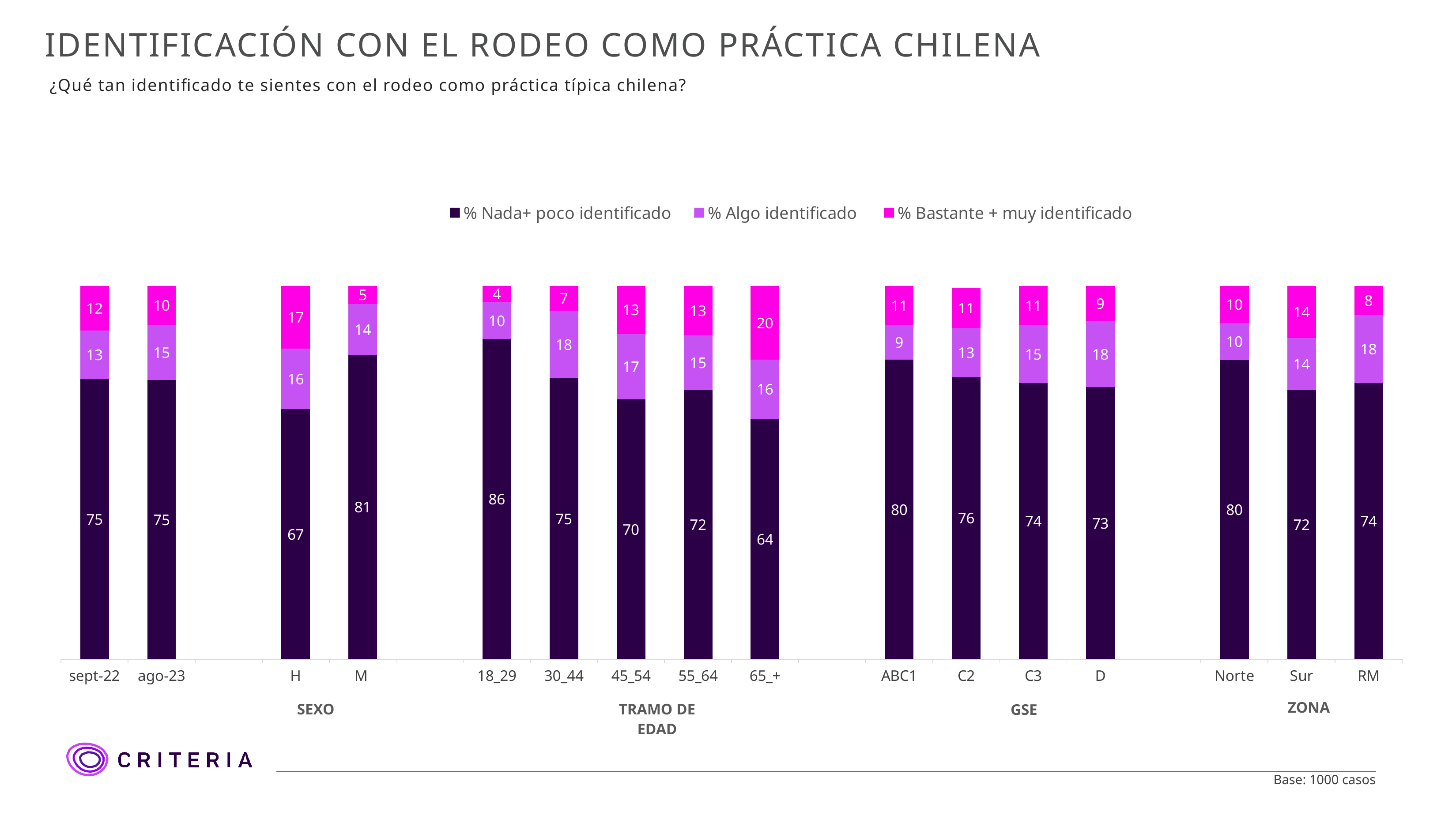
Which has a larger '% Bastante + muy identificado' value, Sur or Norte? Sur Which category has the highest value for '% Nada+ poco identificado'? 18_29 What is the value of '% Algo identificado' for RM? 18 What is the value of '% Nada+ poco identificado' for 18_29? 86 Which group label appears under the categories ABC1, C2, C3 and D? GSE What is the total of the stacked bar for ABC1? 100 What is the difference between the '% Nada+ poco identificado' values for M and H? 14 Which category has the lowest value for '% Bastante + muy identificado'? 18_29 How many series does the legend list? 3 How many categories are plotted along the x axis? 16 What kind of chart is shown on the slide? Stacked bar chart What is the value of '% Bastante + muy identificado' for 65_+? 20